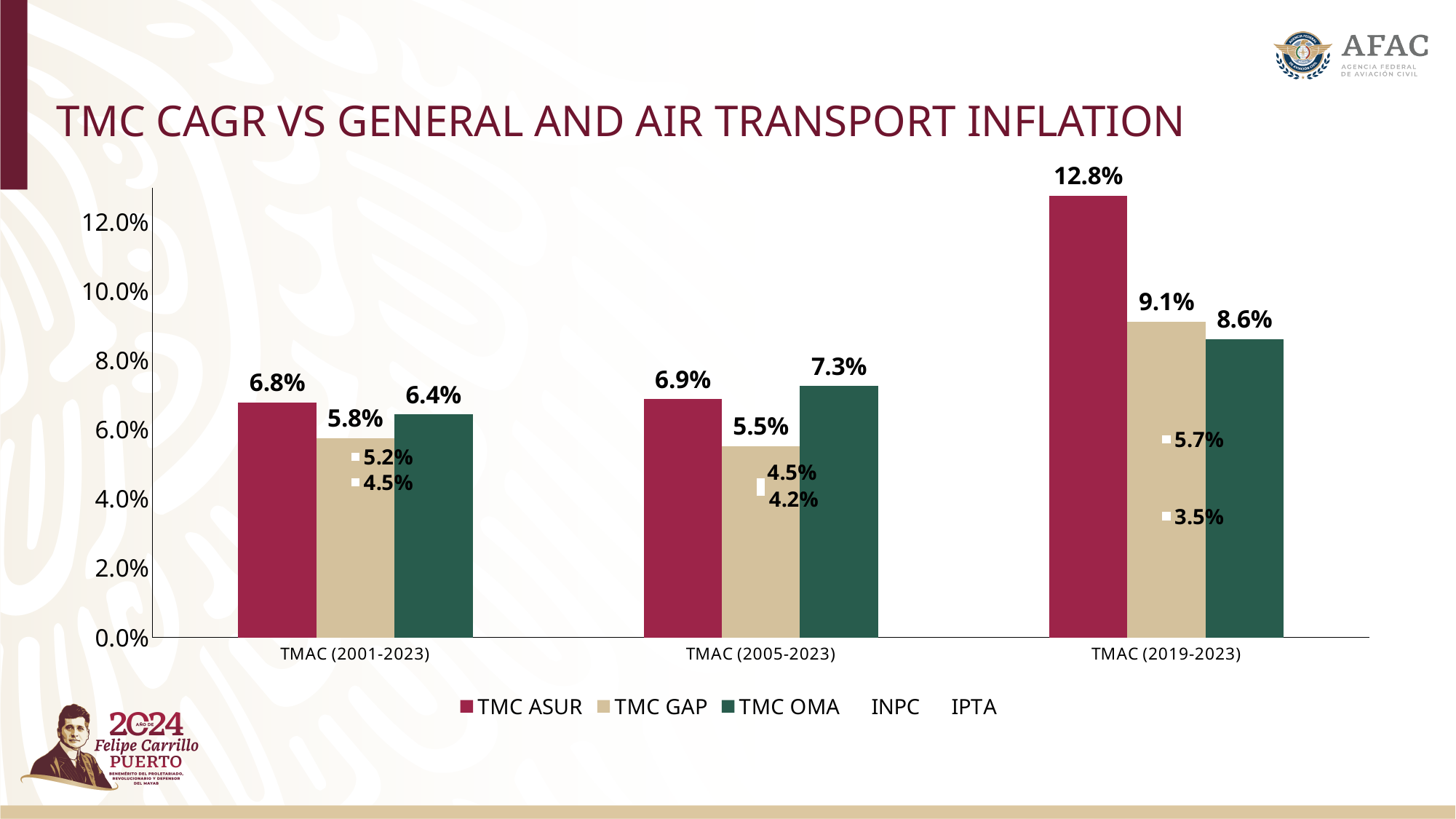
For TMAC (2005-2023), which is larger: TMC ASUR or TMC OMA? TMC OMA What is the TMC OMA value for TMAC (2005-2023)? 7.3% What is the TMC ASUR value for TMAC (2019-2023)? 12.8% Which colour represents TMC OMA in the chart? Dark green Which period has the lowest TMC GAP value? TMAC (2005-2023) What is the difference between the TMC ASUR and TMC GAP values for TMAC (2019-2023)? 3.7% What is the TMC GAP value for TMAC (2001-2023)? 5.8% Which period has the highest TMC ASUR value? TMAC (2019-2023) Is the TMC OMA value for TMAC (2019-2023) greater or less than 8.0%? greater What kind of chart is shown on the slide? Bar chart How many period categories are shown on the x axis? 3 How many series does the legend list? 5